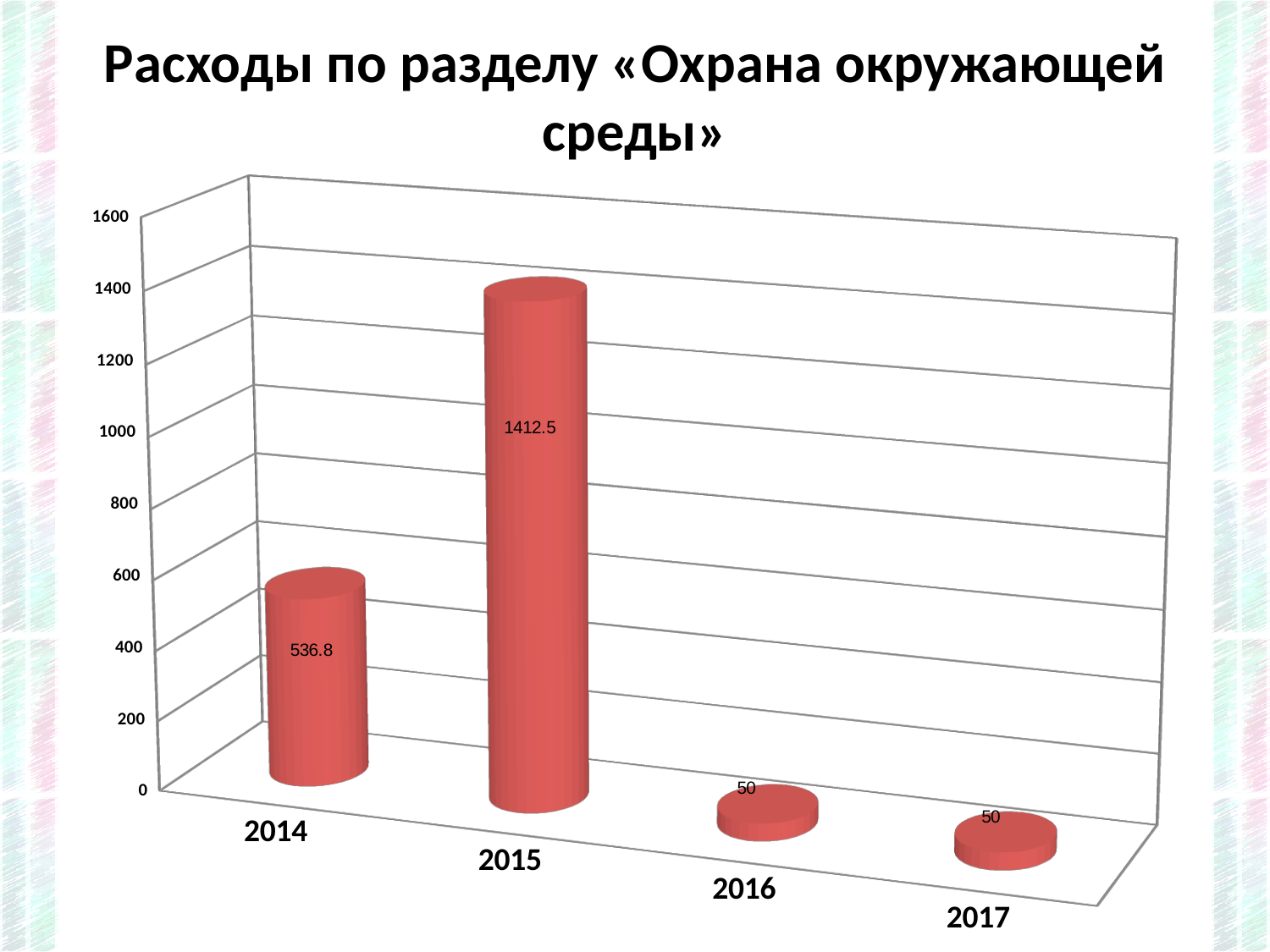
What is the value for 2015? 1412.5 What is the value for 2017? 50 What is the value for 2014? 536.8 What is the difference between the values for 2015 and 2014? 875.7 How many years are shown on the x axis? 4 What is the difference between the values for 2014 and 2016? 486.8 What is the value for 2016? 50 Is the value for 2015 greater or less than 1200? greater Which year has the highest value? 2015 Which is larger, the value for 2014 or the value for 2015? 2015 What is the title of the chart? Расходы по разделу «Охрана окружающей среды» What kind of chart is shown on the slide? bar chart